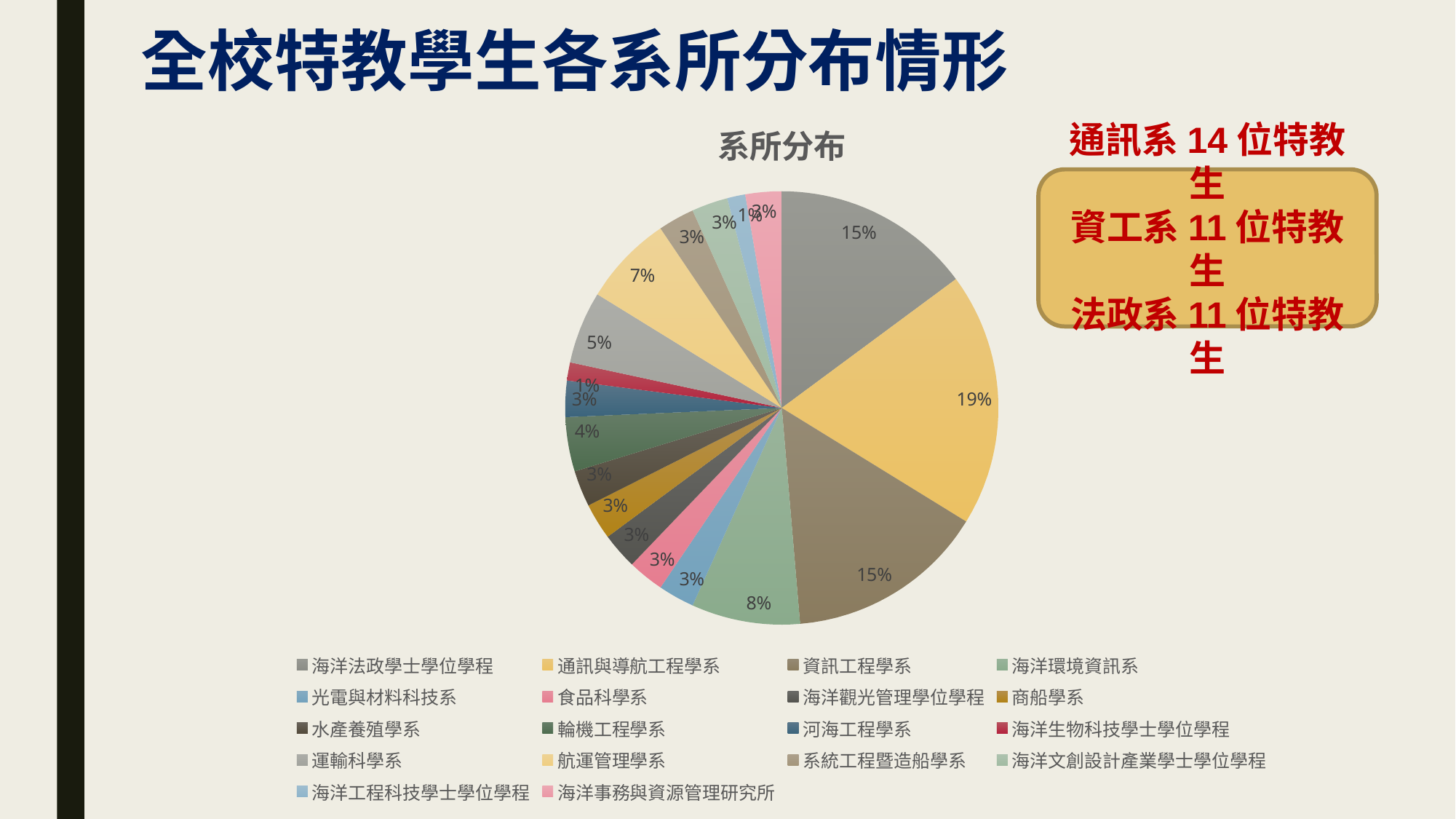
Which has the larger share, 海洋環境資訊系 or 航運管理學系? 海洋環境資訊系 What share of the pie does 通訊與導航工程學系 have? 19% How many categories does the legend of the pie chart list? 18 Which department has the largest share of the pie? 通訊與導航工程學系 What share of the pie does 航運管理學系 have? 7% What is the combined share of 通訊與導航工程學系 and 資訊工程學系? 34% What share of the pie does 海洋環境資訊系 have? 8% What kind of chart is shown on the slide? pie chart What is the difference in share between 通訊與導航工程學系 and 資訊工程學系? 4% What is the title of the chart? 系所分布